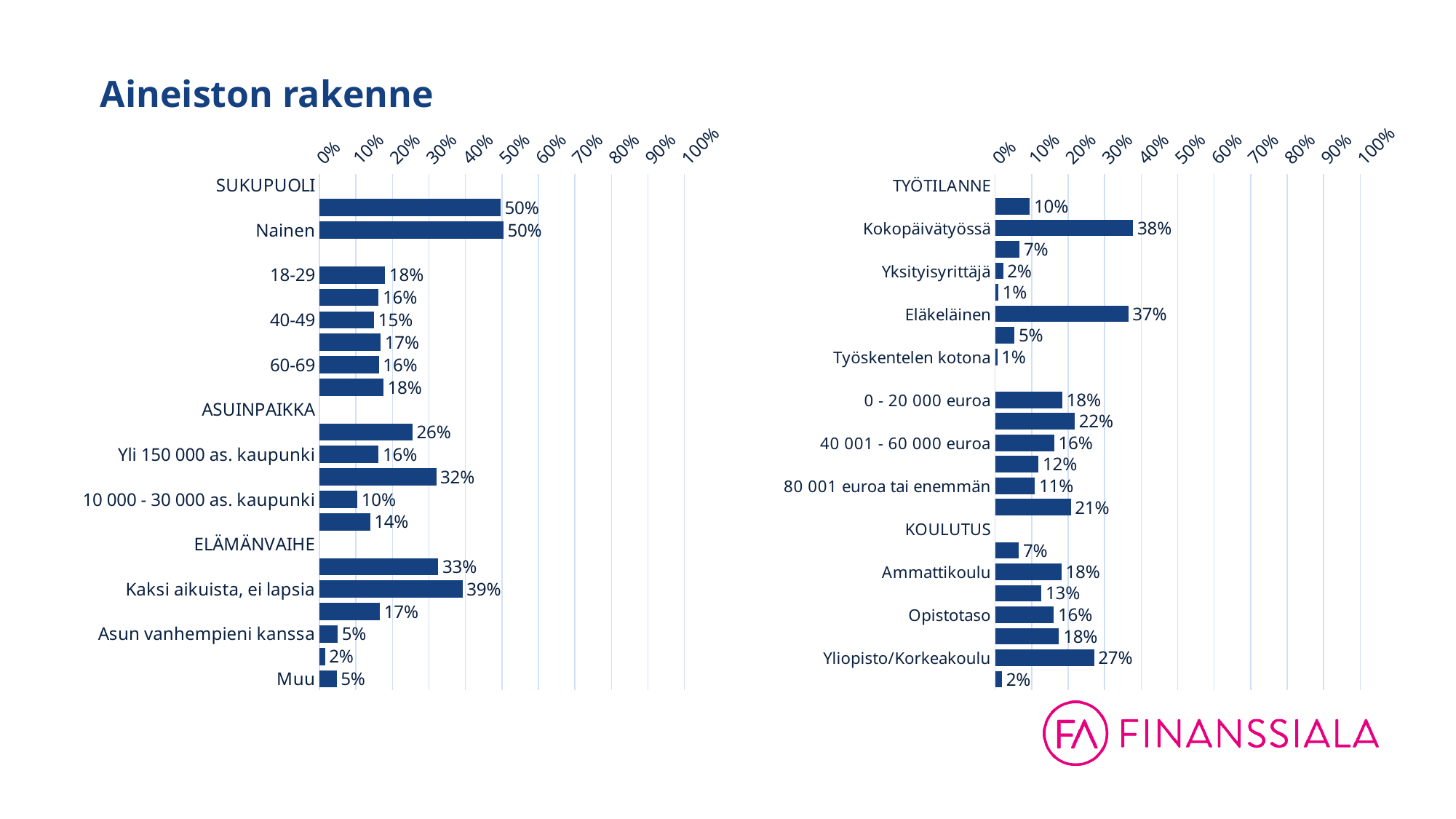
In the right chart, what is the value for Kokopäivätyössä? 38% In the right chart, what is the difference between the values for 0 - 20 000 euroa and 80 001 euroa tai enemmän? 7% In the right chart, what is the value for Työskentelen kotona? 1% In the left chart, which is larger: the value for 40-49 or the value for 60-69? 60-69 In the left chart, what is the value for Kaksi aikuista, ei lapsia? 39% What is the title of the slide? Aineiston rakenne In the left chart, what is the value for Nainen? 50% In the right chart, what is the value for Yliopisto/Korkeakoulu? 27% In the left chart, what is the value for 18-29? 18% What type of chart is shown on the left side of the slide? bar chart In the right chart, is the value for Eläkeläinen greater or less than 30%? greater In the left chart, what is the difference between the values for Yli 150 000 as. kaupunki and 10 000 - 30 000 as. kaupunki? 6%